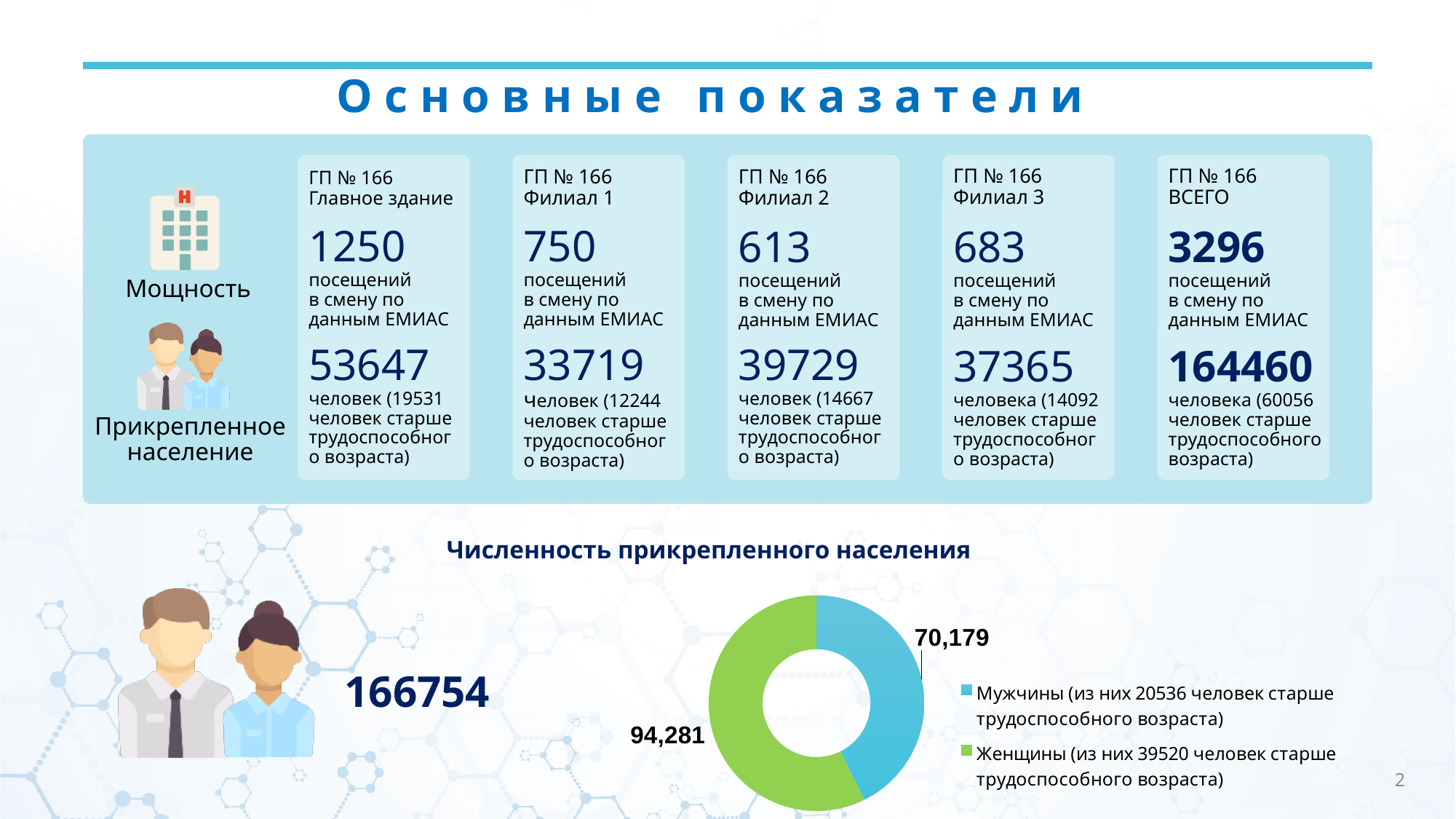
In the doughnut chart, what is the value for Женщины? 94,281 How many slices does the doughnut chart have? 2 In the doughnut chart, is the value for Женщины larger or smaller than the value for Мужчины? larger How many entries does the legend of the doughnut chart list? 2 What kind of chart is shown under the title "Численность прикрепленного населения"? Doughnut (pie) chart What is the difference between the Женщины and Мужчины values in the doughnut chart? 24,102 What is the total of the two slices in the doughnut chart? 164,460 Which category in the doughnut chart has the larger value? Женщины In the doughnut chart, what is the value for Мужчины? 70,179 Which category in the doughnut chart has the smaller value? Мужчины What is the title of the doughnut chart? Численность прикрепленного населения What colour is the Женщины slice in the doughnut chart? Green